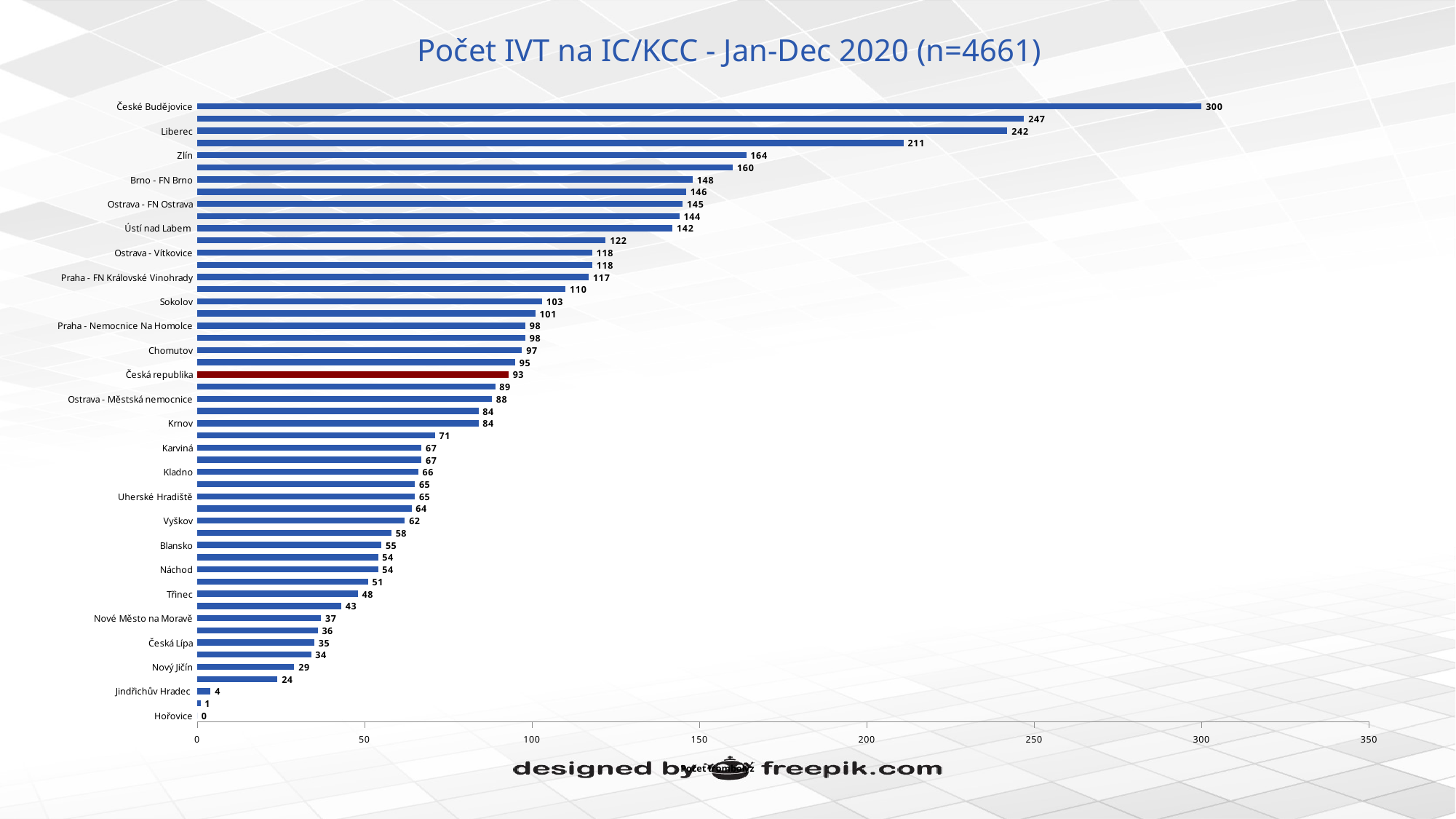
What is the value for České Budějovice? 300 Which category's bar is coloured red instead of blue? Česká republika Which category has the highest value? České Budějovice What is the value for Česká republika? 93 Which has a larger value, Zlín or Brno - FN Brno? Zlín What is the value for Sokolov? 103 What is the value for Liberec? 242 What is the title of the chart? Počet IVT na IC/KCC - Jan-Dec 2020 (n=4661) Is the value for Ústí nad Labem greater or less than 100? greater What type of chart is shown on the slide? bar chart What is the difference between the values for České Budějovice and Liberec? 58 Which category has the lowest value? Hořovice